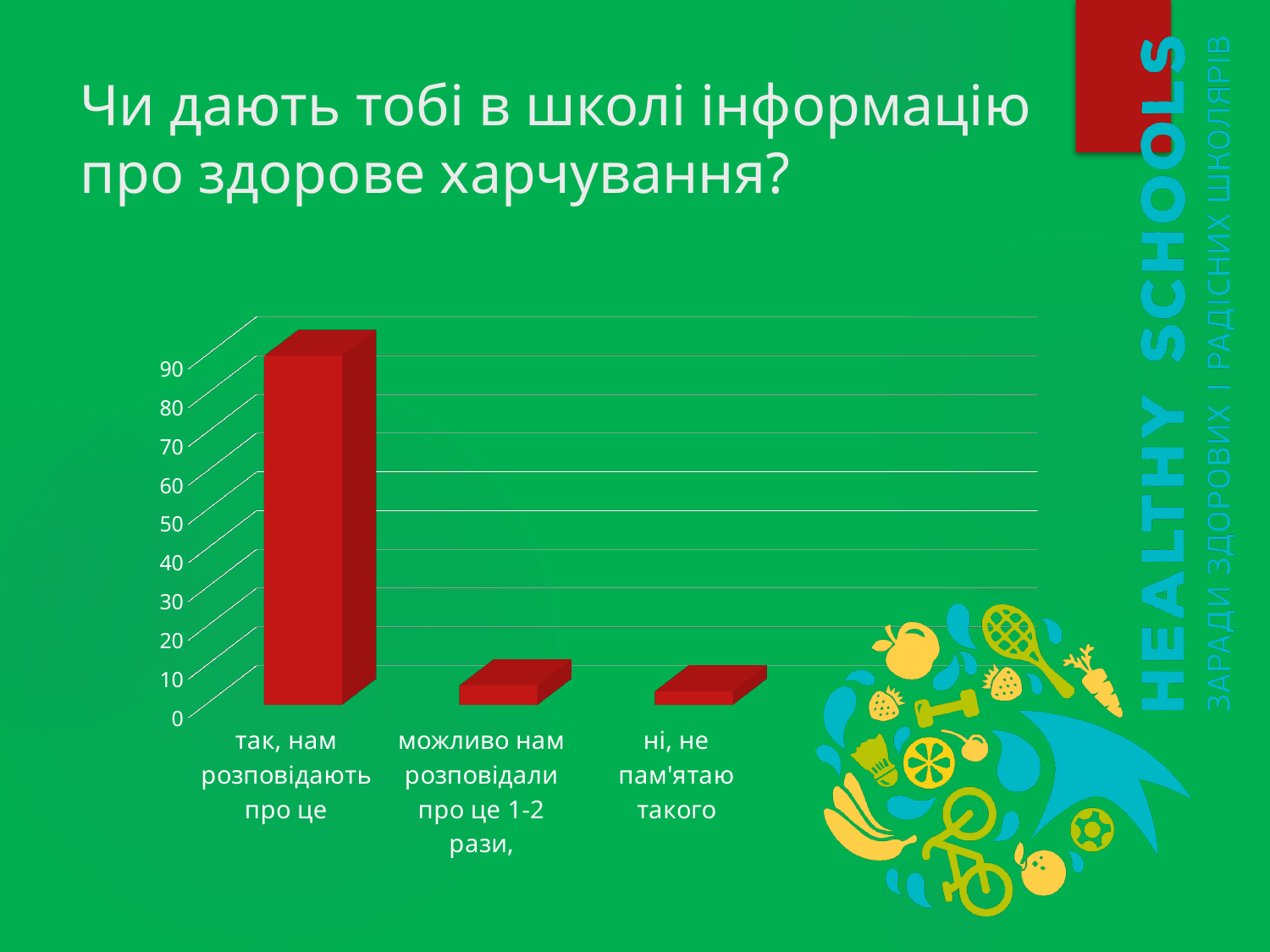
Which category has the highest value in the chart? так, нам розповідають про це Is the value for "ні, не пам'ятаю такого" greater or less than 10? less What colour are the bars in the chart? red Which is larger: the value for "так, нам розповідають про це" or the value for "ні, не пам'ятаю такого"? так, нам розповідають про це Do the values rise or fall from the first category to the second category along the x axis? fall How many categories are shown on the x axis of the chart? 3 Is the value for "так, нам розповідають про це" greater or less than 50? greater Which is larger: the value for "так, нам розповідають про це" or the value for "можливо нам розповідали про це 1-2 рази,"? так, нам розповідають про це Is the value for "так, нам розповідають про це" greater or less than 80? greater What kind of chart is shown on the slide? bar chart What is the highest tick value shown on the vertical axis of the chart? 90